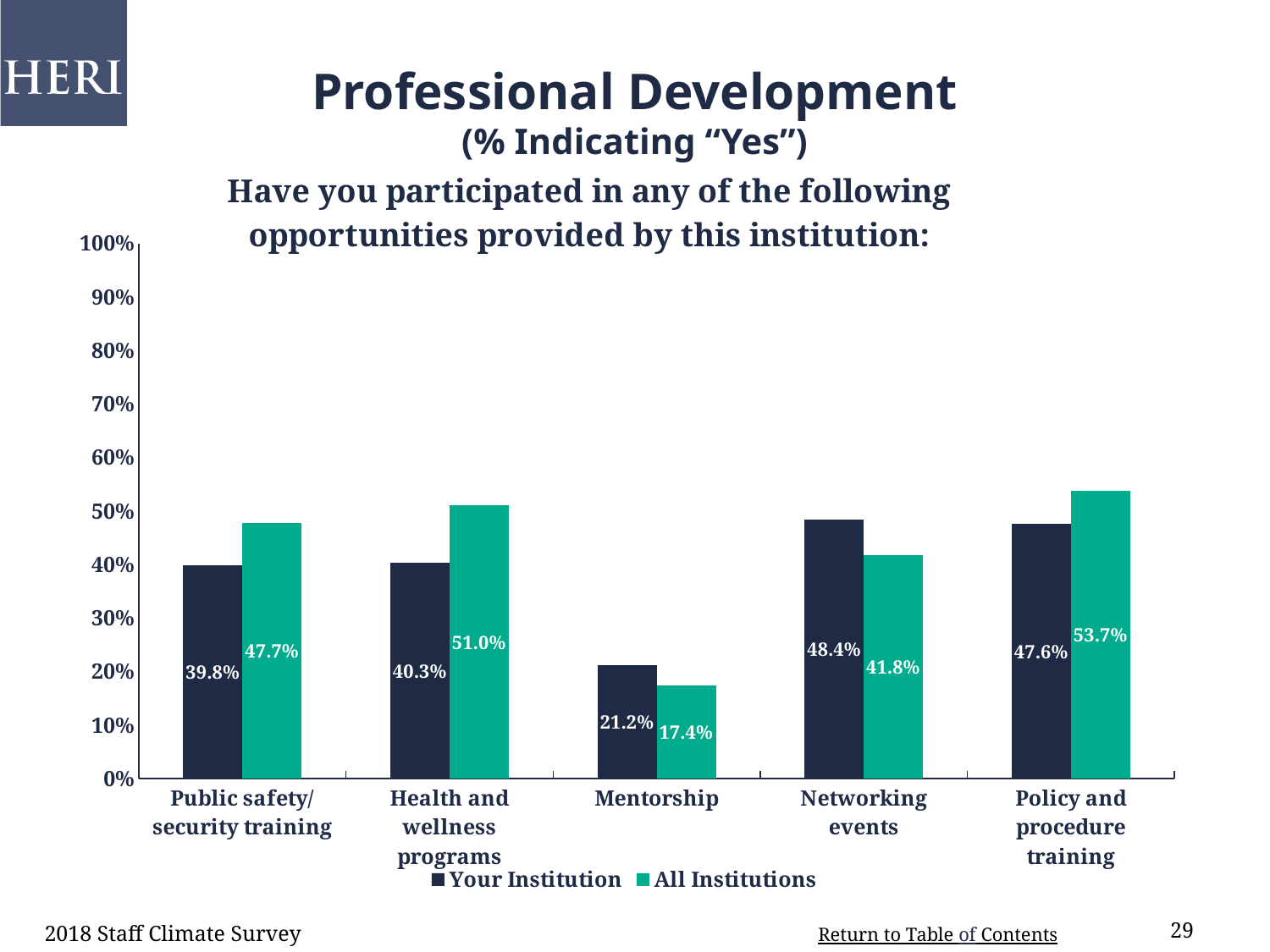
What is the title of the chart? Have you participated in any of the following opportunities provided by this institution: How many categories are shown on the x axis? 5 What is the value for All Institutions for Policy and procedure training? 53.7% For Networking events, which is larger: Your Institution or All Institutions? Your Institution Which category has the lowest value for Your Institution? Mentorship How many series does the legend list? 2 Which category has the highest value for All Institutions? Policy and procedure training Is the value for All Institutions for Mentorship greater or less than 20%? less What is the difference between All Institutions and Your Institution for Public safety/security training? 7.9% What kind of chart is shown on the slide? Bar chart What is the value for All Institutions for Health and wellness programs? 51.0% What is the value for Your Institution for Mentorship? 21.2%